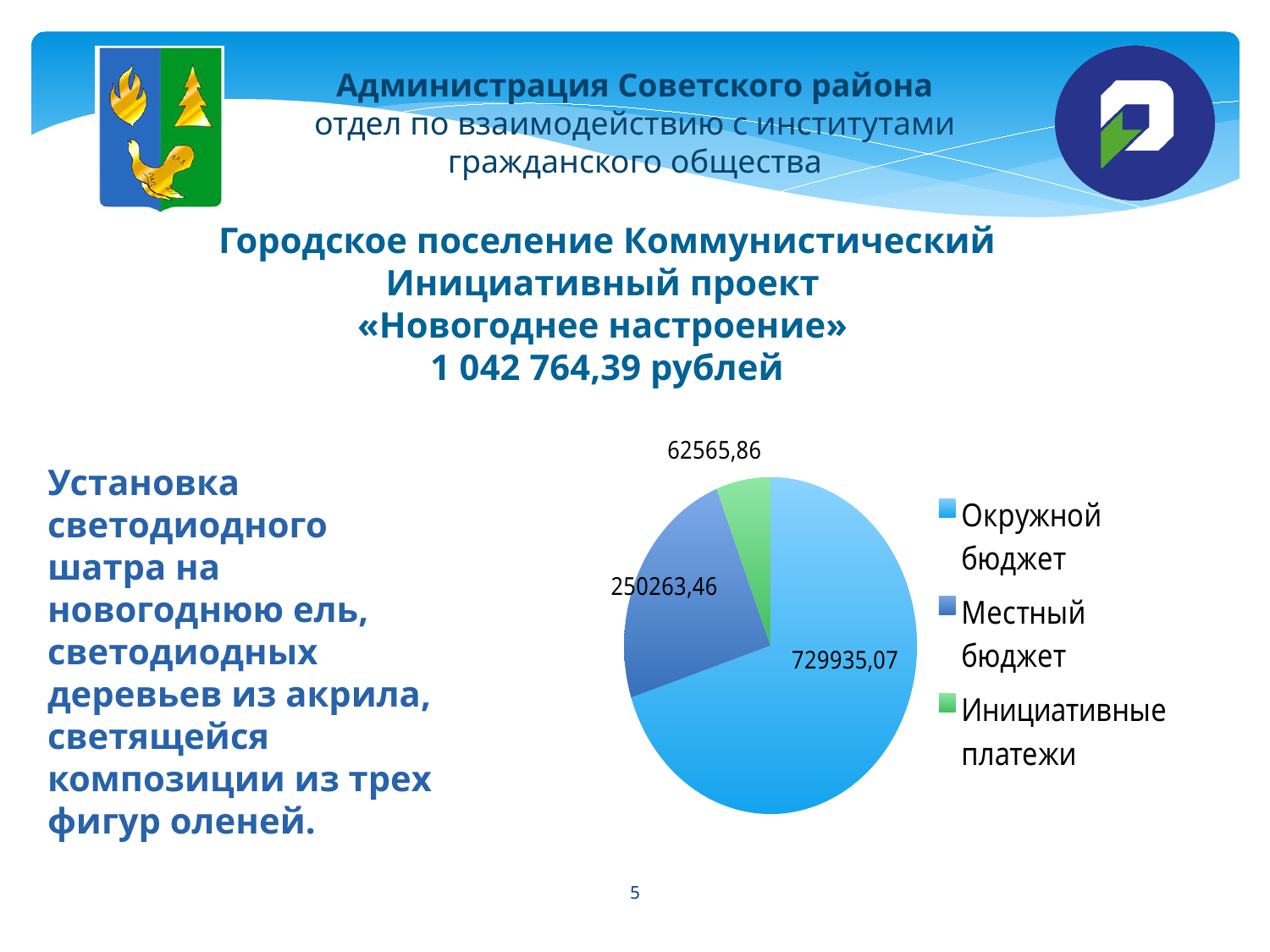
Which is larger: Местный бюджет or Инициативные платежи? Местный бюджет What share of the pie does Окружной бюджет represent? 70% Which category has the smallest slice in the pie chart? Инициативные платежи Which category has the largest slice in the pie chart? Окружной бюджет What is the difference between the values for Окружной бюджет and Местный бюджет? 479671,61 What is the value for Инициативные платежи in the pie chart? 62565,86 What is the value for Местный бюджет in the pie chart? 250263,46 What colour is the slice for Инициативные платежи in the pie chart? green How many entries does the legend of the pie chart list? 3 What is the value for Окружной бюджет in the pie chart? 729935,07 How many slices does the pie chart have? 3 What type of chart is shown on the slide? pie chart